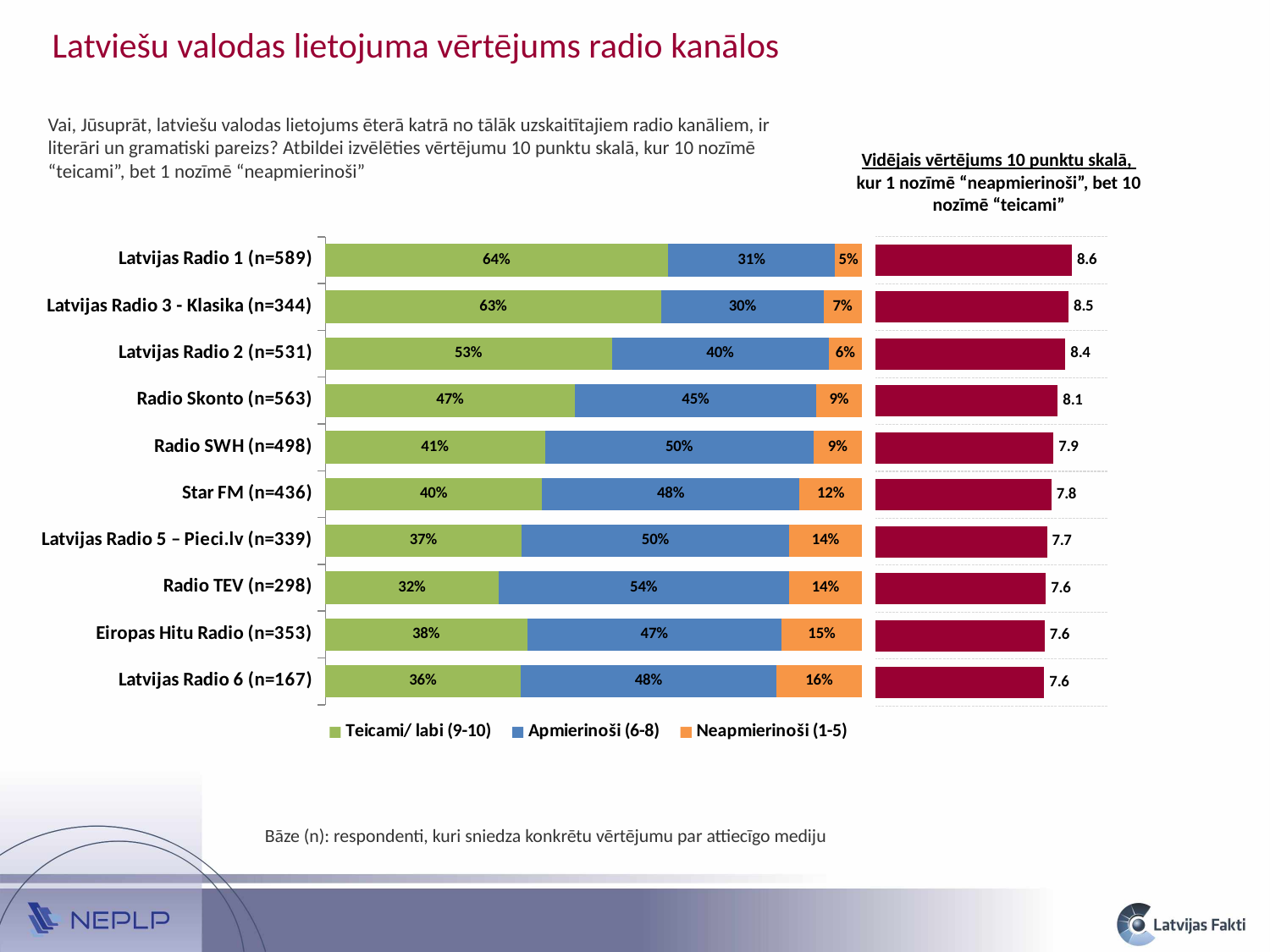
In the left stacked bar chart, what is the total of the three segments for Latvijas Radio 1 (n=589)? 100% In the right chart (Vidējais vērtējums 10 punktu skalā), do the average scores rise or fall going from the top channel to the bottom channel? Fall How many series does the legend of the left stacked bar chart list? 3 How many radio channels are listed in the left stacked bar chart? 10 In the left stacked bar chart, which radio channel has the lowest Neapmierinoši (1-5) share? Latvijas Radio 1 (n=589) In the left stacked bar chart, what is the Neapmierinoši (1-5) share for Latvijas Radio 6 (n=167)? 16% In the left stacked bar chart, what percentage of respondents rated Latvijas Radio 1 (n=589) as Teicami/ labi (9-10)? 64% In the left stacked bar chart, which has the larger Apmierinoši (6-8) share: Radio TEV (n=298) or Star FM (n=436)? Radio TEV (n=298) In the right chart (Vidējais vērtējums 10 punktu skalā), what is the average score for Radio Skonto (n=563)? 8.1 In the right chart (Vidējais vērtējums 10 punktu skalā), which radio channel has the highest average score? Latvijas Radio 1 (n=589) What type of chart is the left chart on the slide? Stacked bar chart In the right chart (Vidējais vērtējums 10 punktu skalā), what is the difference between the average scores of Latvijas Radio 1 (n=589) and Latvijas Radio 6 (n=167)? 1.0